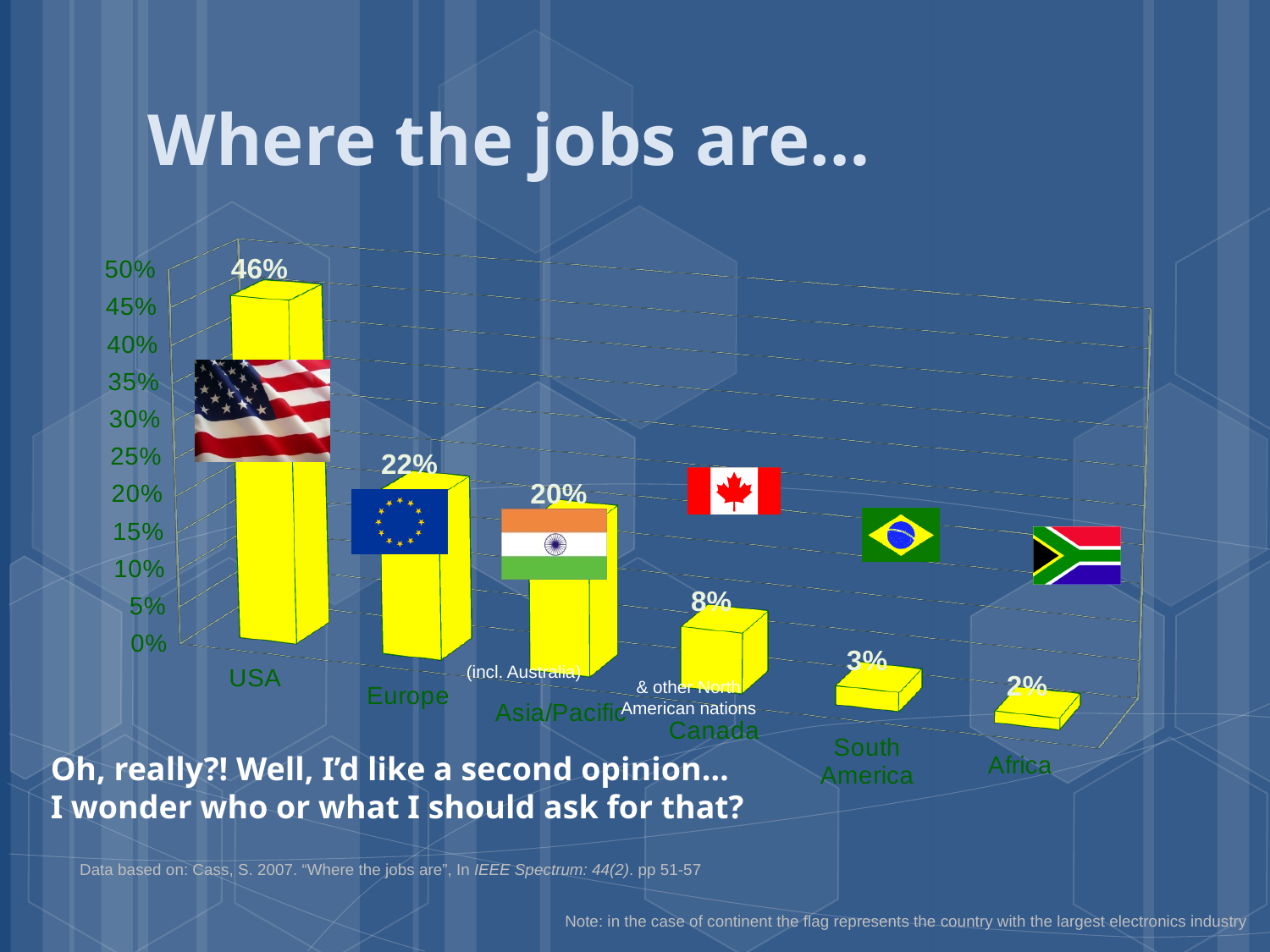
How many categories are shown in the chart? 6 What is the value for Asia/Pacific? 20% What is the value for Africa? 2% Which category has the lowest value? Africa Do the values rise or fall from left to right along the x axis? fall What kind of chart is shown on the slide? bar chart What is the difference between the values for USA and Europe? 24% What is the value for Europe? 22% Which category has the highest value? USA What is the value for Canada? 8% Which is larger, the value for Canada or the value for South America? Canada What is the value for USA? 46%